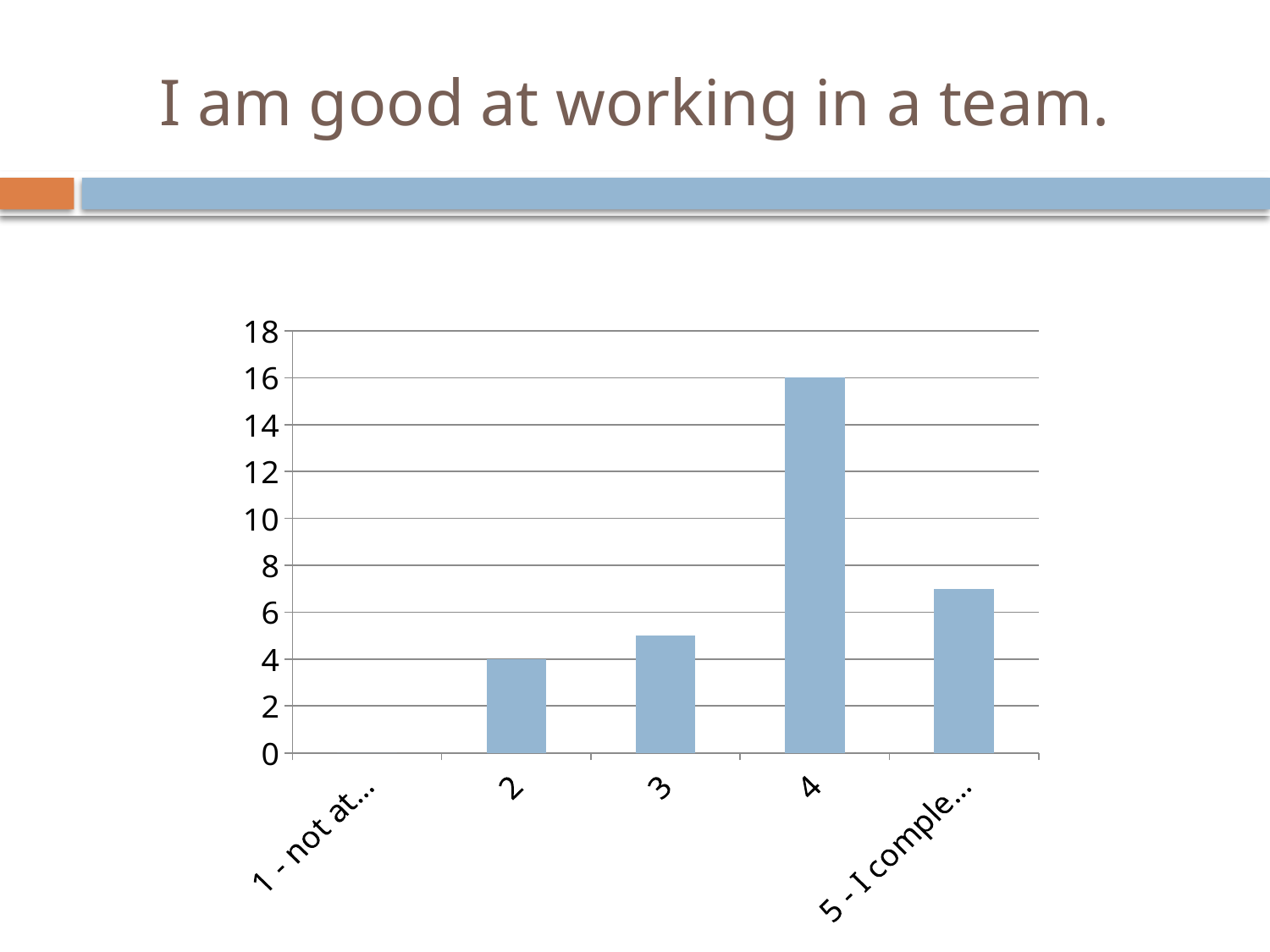
What is the title of the slide above the chart? I am good at working in a team. What is the highest value shown on the y axis? 18 Which has a larger value, category 2 or category 3? 3 Which category has the highest value? 4 How many categories are shown on the x axis? 5 What is the difference between the values for category 4 and category 2? 12 Which has a larger value, category 4 or category 5? 4 Is the value for category 3 greater or less than 4? greater Is the value for category 5 greater or less than 8? less What is the value for category 2? 4 What is the value for category 4? 16 What type of chart is shown on the slide? bar chart